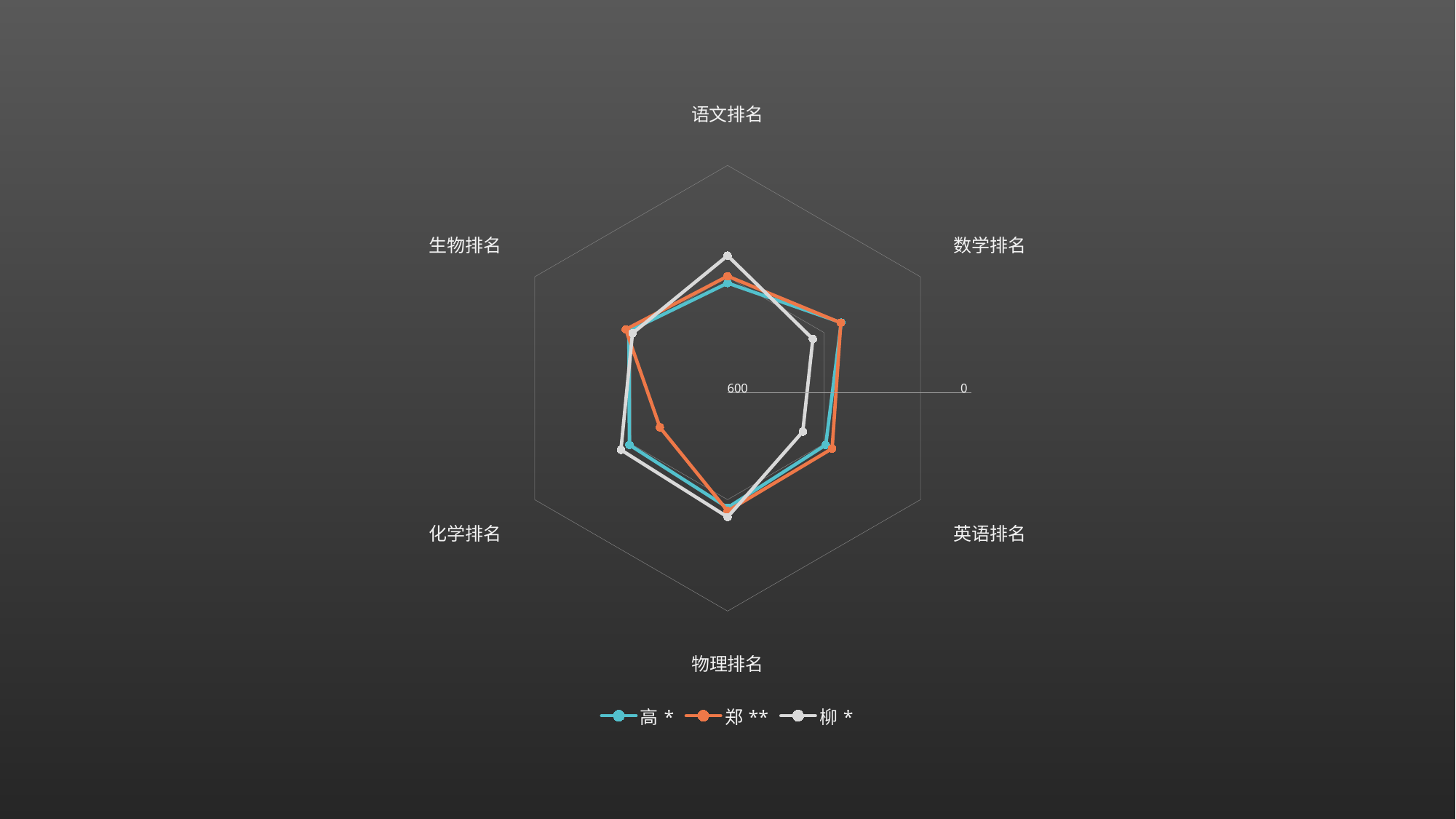
Which category label appears at the top of the radar chart? 语文排名 What colour is the line for the series 郑 **? orange Which series are listed in the legend? 高 *, 郑 **, 柳 * What value is shown at the centre of the radar chart's axis? 600 Is the value for 郑 ** in 化学排名 greater or less than 600? less How many series does the legend list? 3 What kind of chart is shown on the slide? radar chart How many categories (axes) does the radar chart have? 6 What value is shown at the outer end of the radar chart's axis? 0